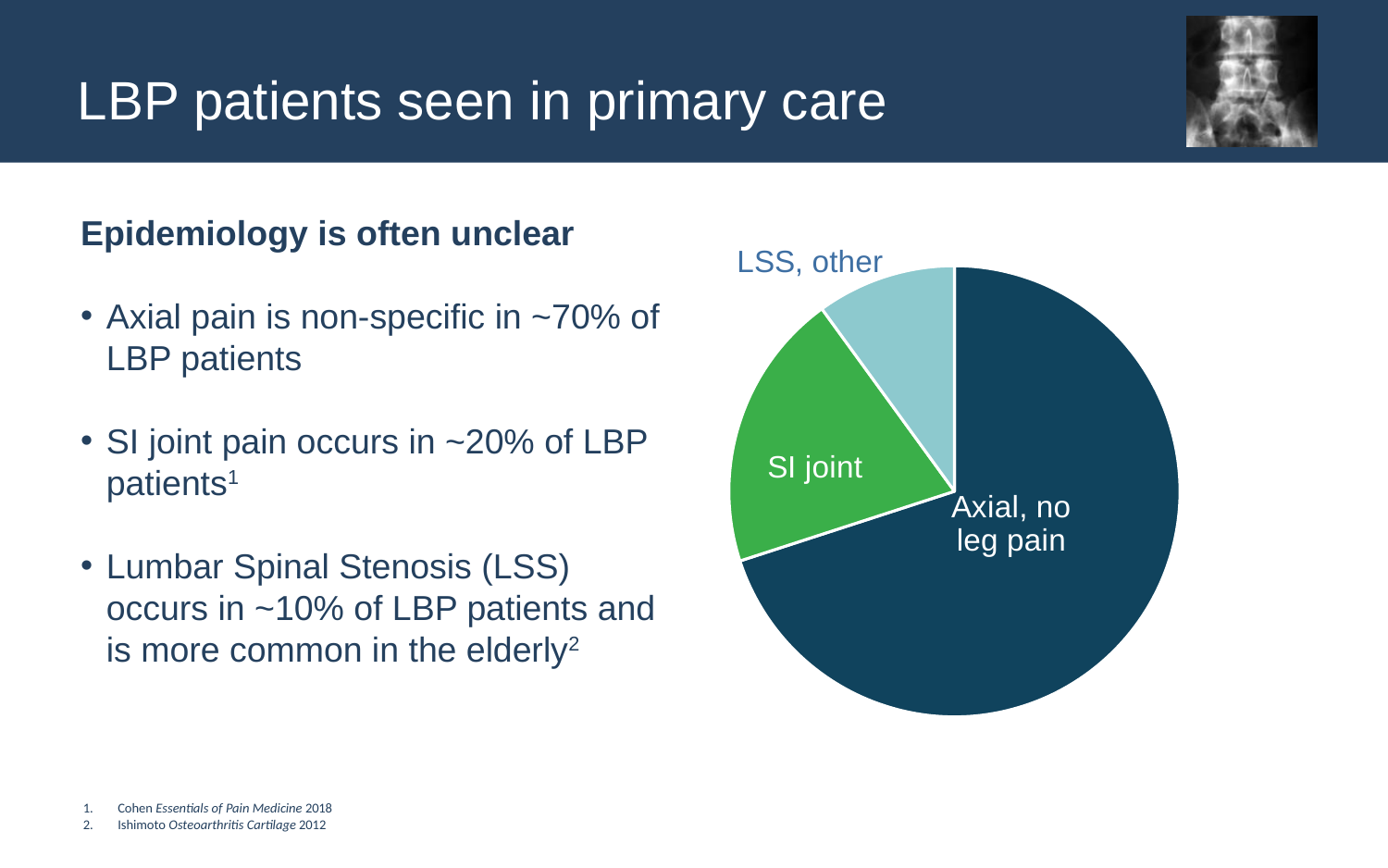
Which slice is larger in the pie chart, Axial, no leg pain or SI joint? Axial, no leg pain Does the Axial, no leg pain slice take up more or less than half of the pie chart? more Which slice of the pie chart is coloured light blue? LSS, other What kind of chart is shown on the slide? pie chart Which slice of the pie chart is the smallest? LSS, other How many slices does the pie chart have? 3 What colour is the SI joint slice in the pie chart? green Which slice is larger in the pie chart, SI joint or LSS, other? SI joint Which slice of the pie chart is the largest? Axial, no leg pain